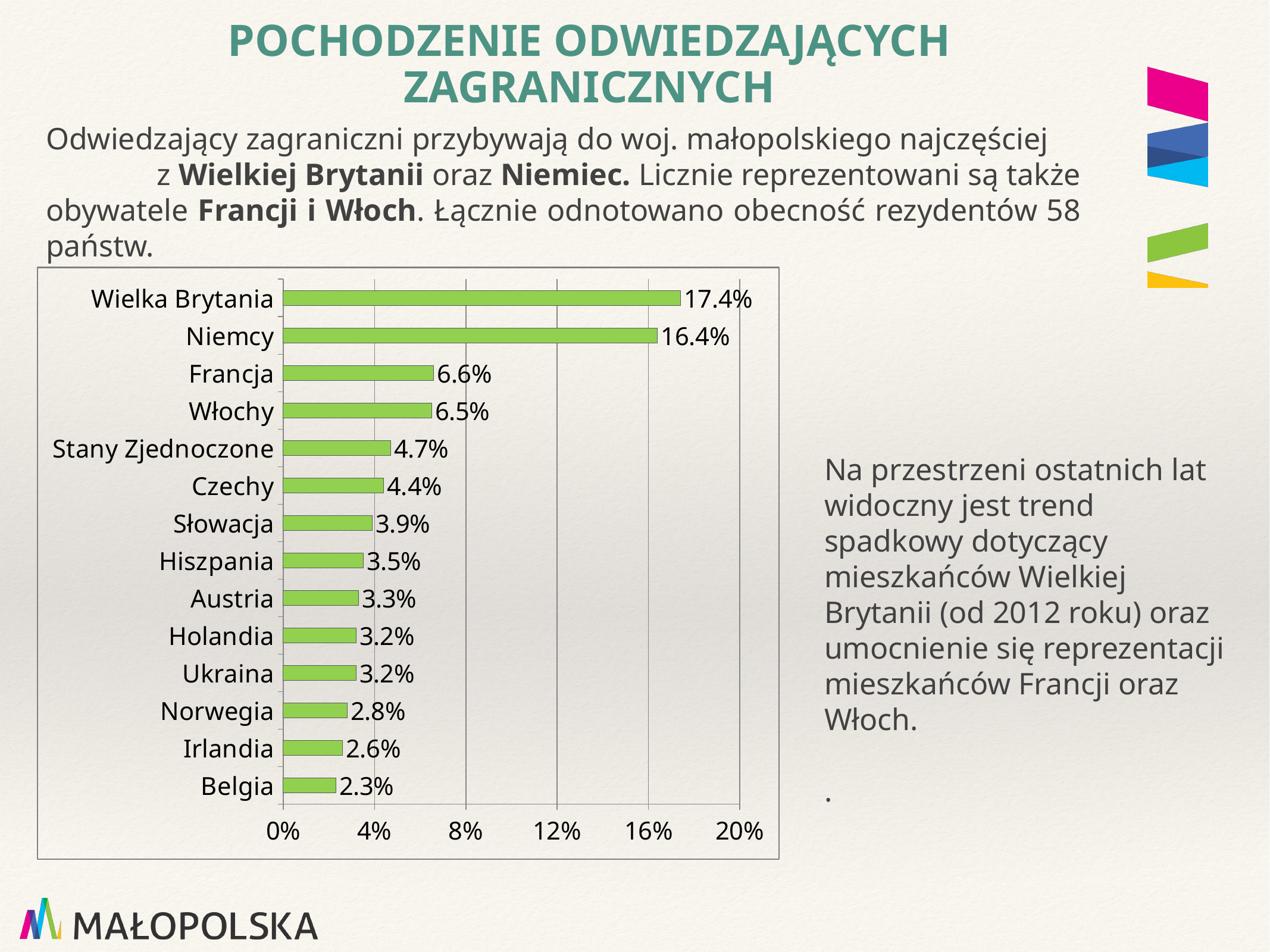
What kind of chart is shown on the slide? bar chart Which is larger, the value for Stany Zjednoczone or the value for Słowacja? Stany Zjednoczone What is the value for Belgia? 2.3% Which country has the lowest value? Belgia What is the value for Wielka Brytania? 17.4% What is the value for Czechy? 4.4% What is the difference between the values for Francja and Włochy? 0.1% Which country has the highest value? Wielka Brytania What is the value for Francja? 6.6% How many countries are shown in the chart? 14 What is the difference between the values for Wielka Brytania and Niemcy? 1.0% Is the value for Niemcy greater or less than 12%? greater